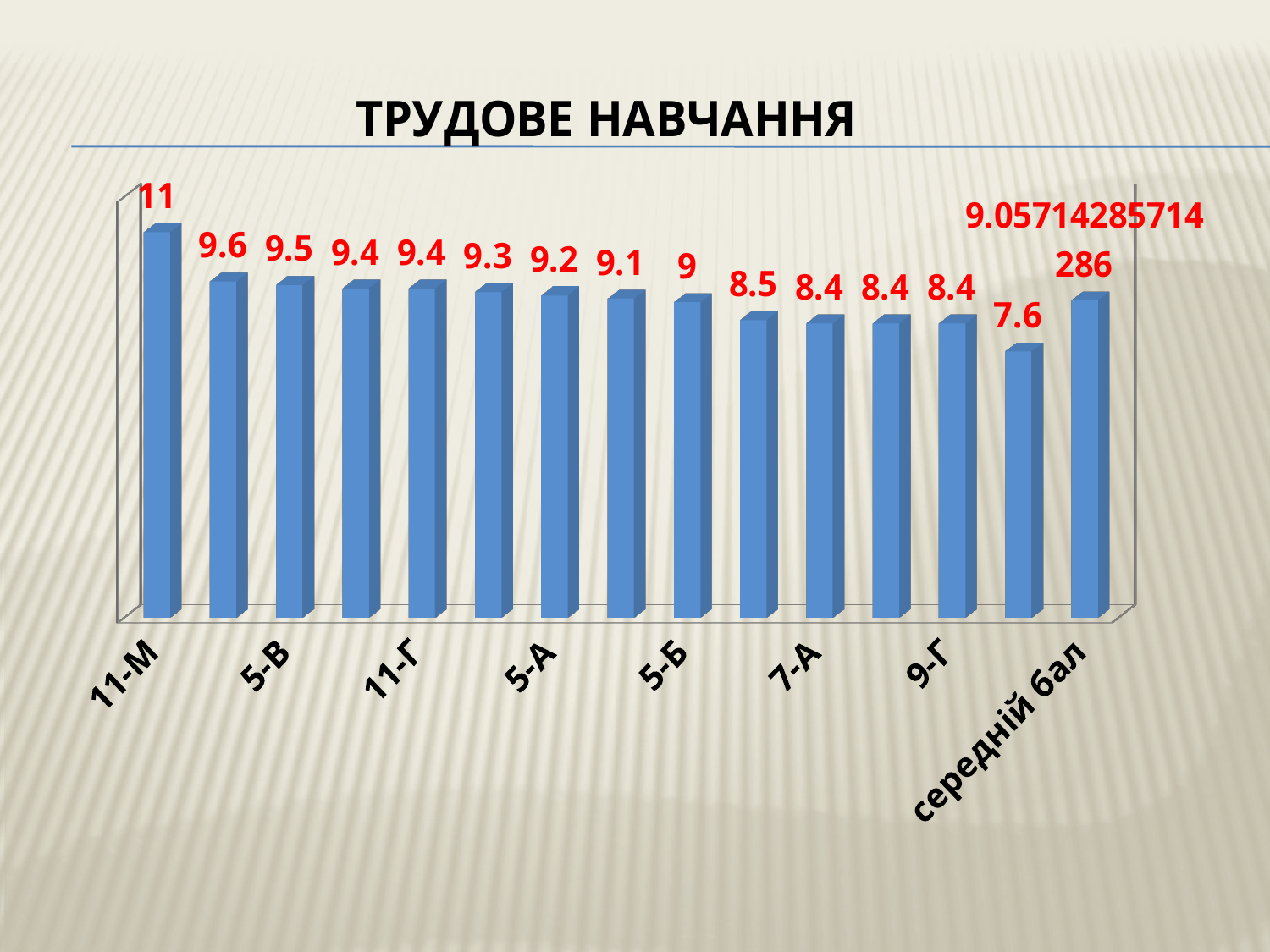
What is the value for 7-А? 8.4 How many bars are plotted on the chart? 15 Which is larger, the value for 5-В or the value for 5-А? 5-В What is the value for 5-Б? 9 What is the value for 5-В? 9.5 What is the value for 11-Г? 9.4 What is the value for 5-А? 9.2 Which labelled category has the highest value? 11-М What is the difference between the values for 11-М and 5-В? 1.5 What is the lowest value shown on the chart? 7.6 What is the value for 11-М? 11 What value is shown for середній бал? 9.05714285714286